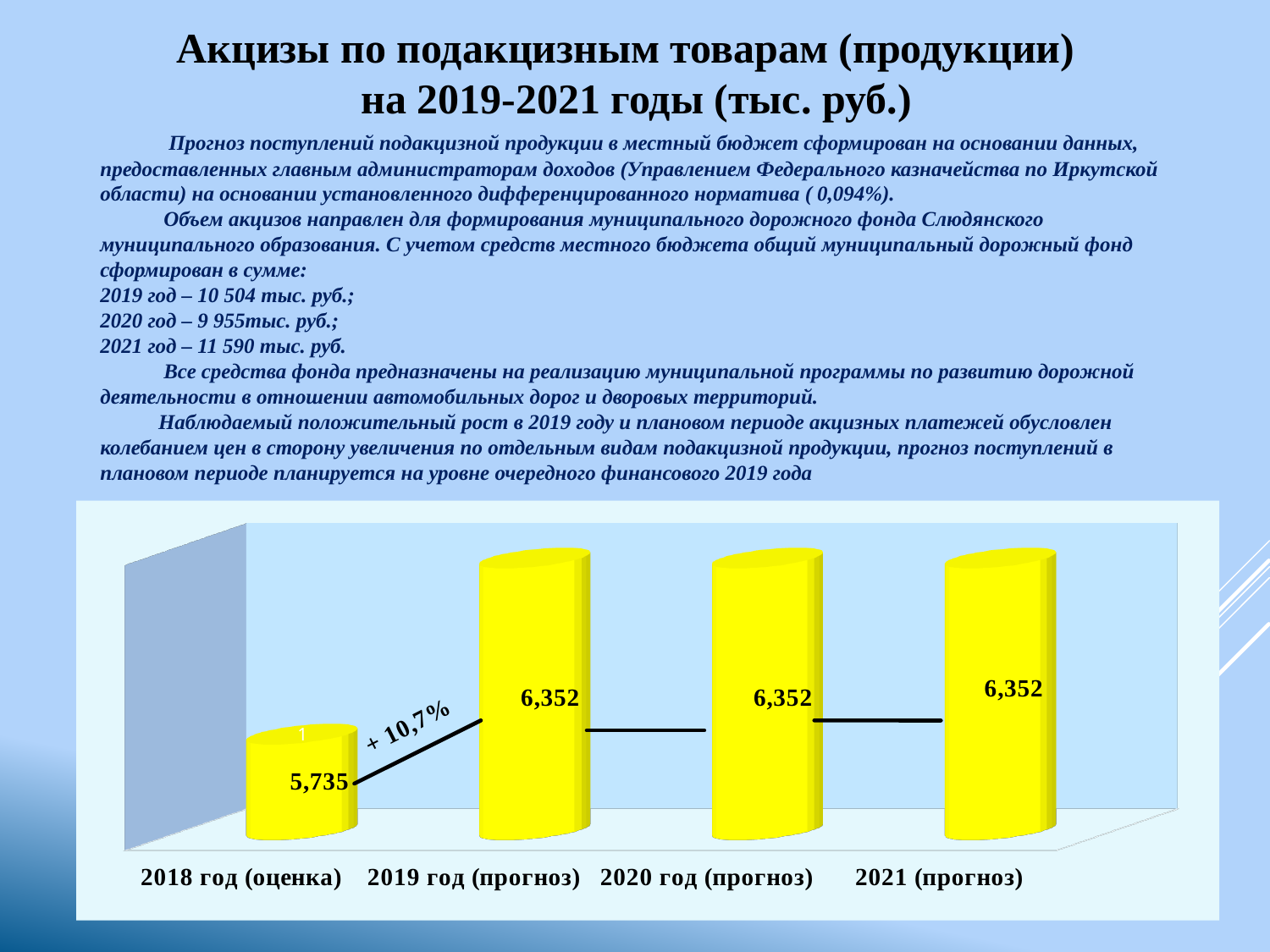
What is the difference between the values for 2019 год (прогноз) and 2018 год (оценка)? 617 Which category has the lowest value? 2018 год (оценка) What is the value for 2020 год (прогноз)? 6,352 What colour are the bars in the chart? Yellow Which is larger, the value for 2018 год (оценка) or the value for 2019 год (прогноз)? 2019 год (прогноз) How many categories are shown in the chart? 4 Does the value rise or fall from 2018 год (оценка) to 2019 год (прогноз)? Rise What is the value for 2019 год (прогноз)? 6,352 What kind of chart is shown on the slide? Bar chart What is the value for 2018 год (оценка)? 5,735 What is the value for 2021 (прогноз)? 6,352 What percentage change is annotated between the 2018 and 2019 bars? + 10,7%